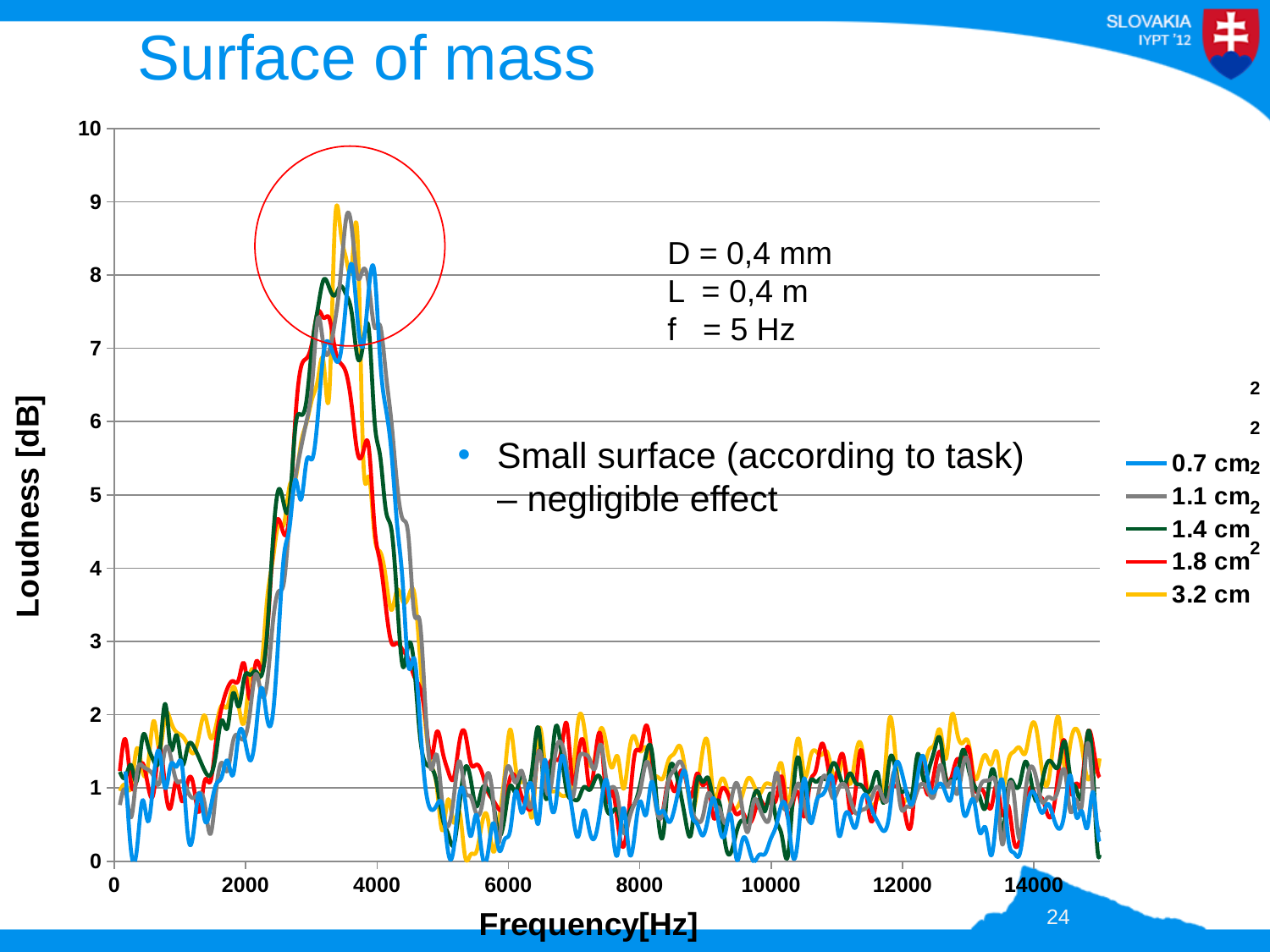
How many series does the legend list? 5 Do the loudness values rise or fall along the x axis between 4000 Hz and 6000 Hz? fall What kind of chart is shown on the slide? line chart What is the highest tick value shown on the y axis? 10 What is the label of the x axis? Frequency[Hz] Which series has the lowest peak loudness? 1.8 cm² Is the peak value of the 0.7 cm² series greater or less than 7? greater Is the value of the 1.1 cm² series at 10000 Hz greater or less than 3? less Is the peak of the 1.4 cm² series greater or less than 6? greater What is the label of the y axis? Loudness [dB]